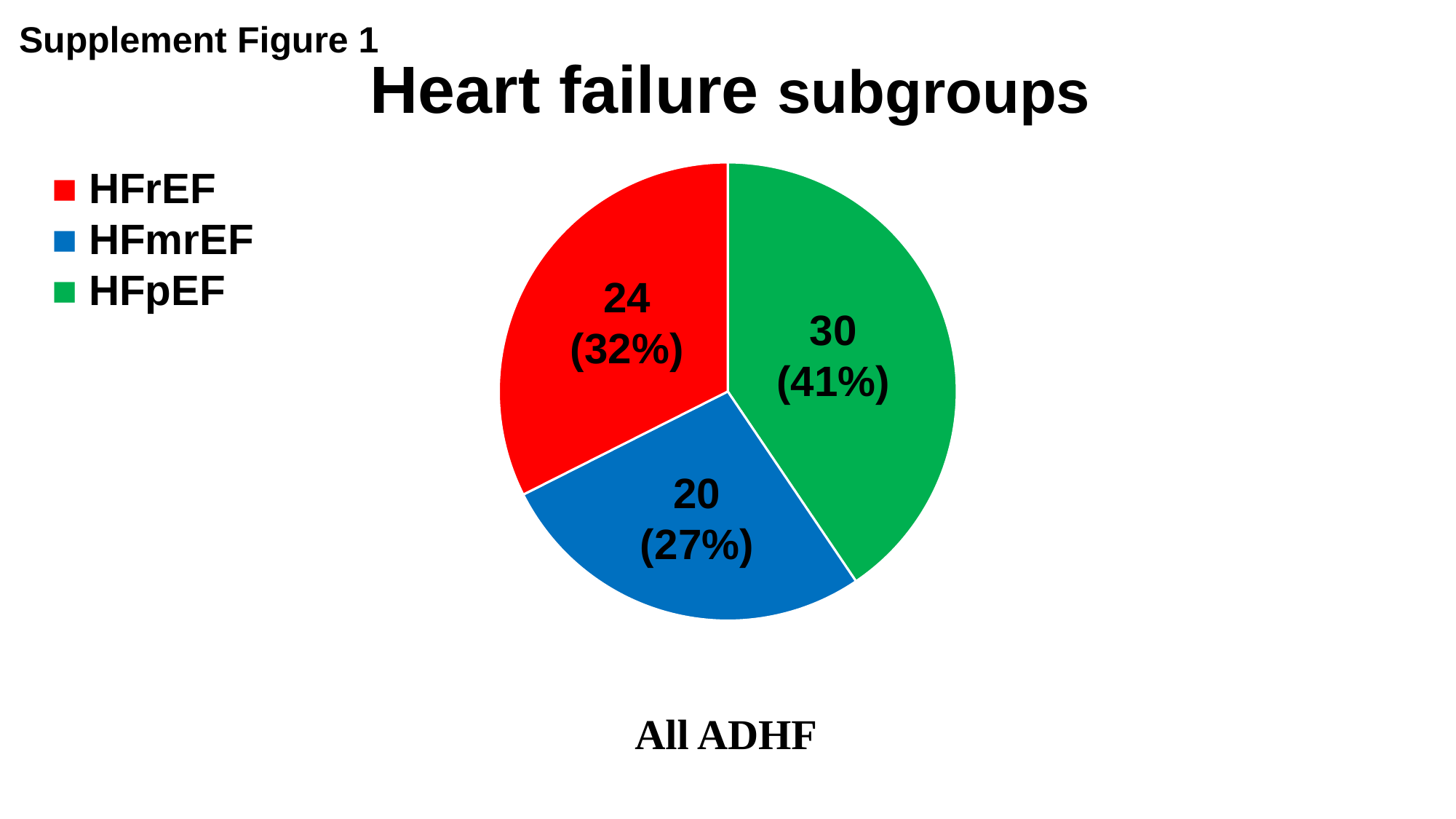
How many entries does the legend list? 3 What share of the pie does HFpEF represent? 41% What is the count for HFpEF? 30 What is the count for HFmrEF? 20 What type of chart is shown on the slide? pie chart What share of the pie does HFmrEF represent? 27% Which subgroup has the smallest slice? HFmrEF What is the difference between the HFpEF count and the HFrEF count? 6 What is the count for HFrEF? 24 Which subgroup has the largest slice? HFpEF How many slices does the pie chart have? 3 What is the title of the chart? Heart failure subgroups